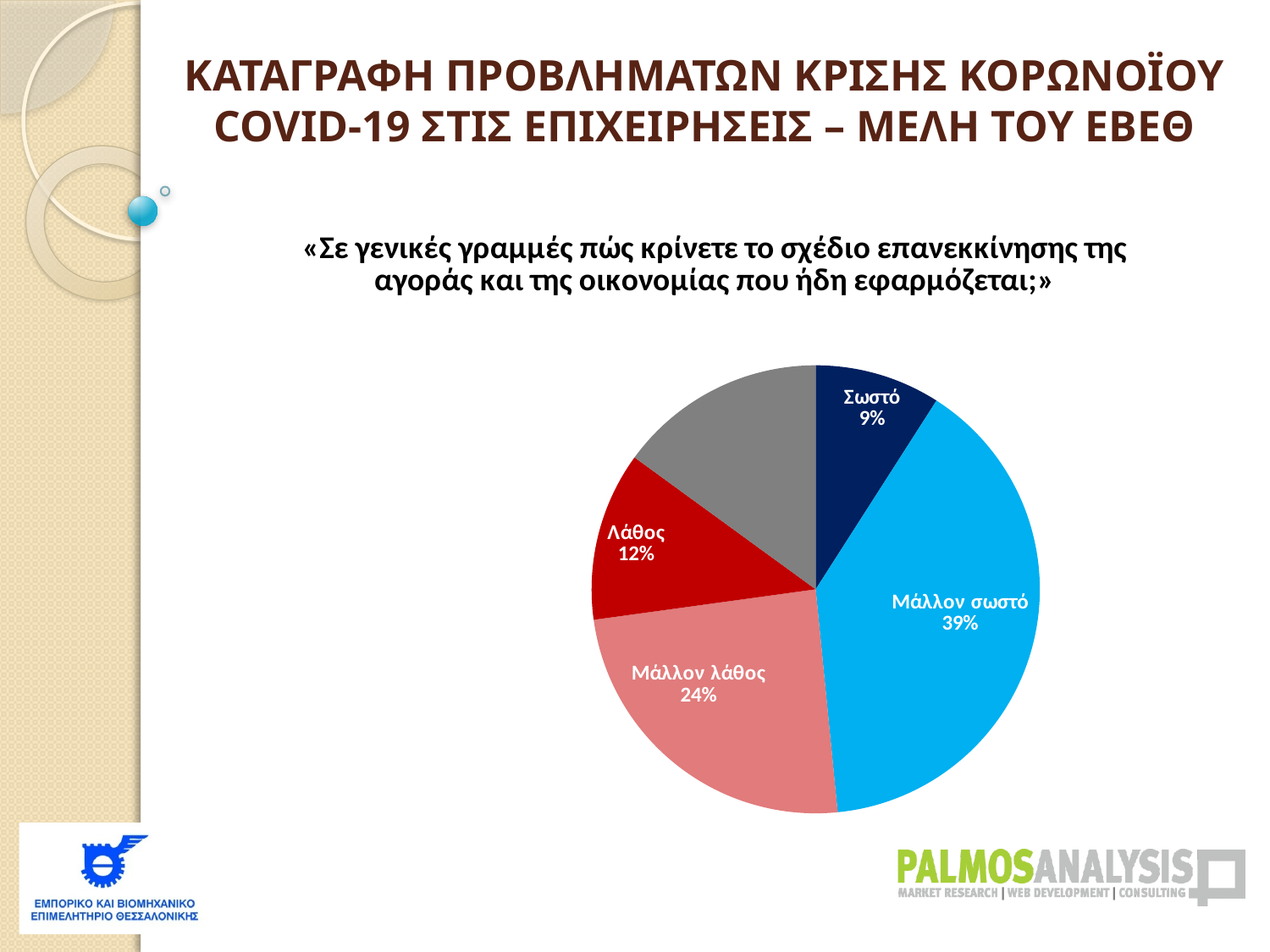
What kind of chart is shown on the slide? pie chart What percentage of the pie is labelled "Μάλλον λάθος"? 24% How many slices does the pie chart have? 5 What percentage of the pie is labelled "Μάλλον σωστό"? 39% What is the difference in percentage points between "Μάλλον σωστό" and "Μάλλον λάθος"? 15 What percentage of the pie is labelled "Σωστό"? 9% What percentage of the pie is labelled "Λάθος"? 12% Which is larger, the "Μάλλον λάθος" slice or the "Λάθος" slice? Μάλλον λάθος Which slice of the pie is the largest? Μάλλον σωστό What is the difference in percentage points between "Λάθος" and "Σωστό"? 3 What colour is the "Μάλλον σωστό" slice? light blue Which slice of the pie is the smallest? Σωστό